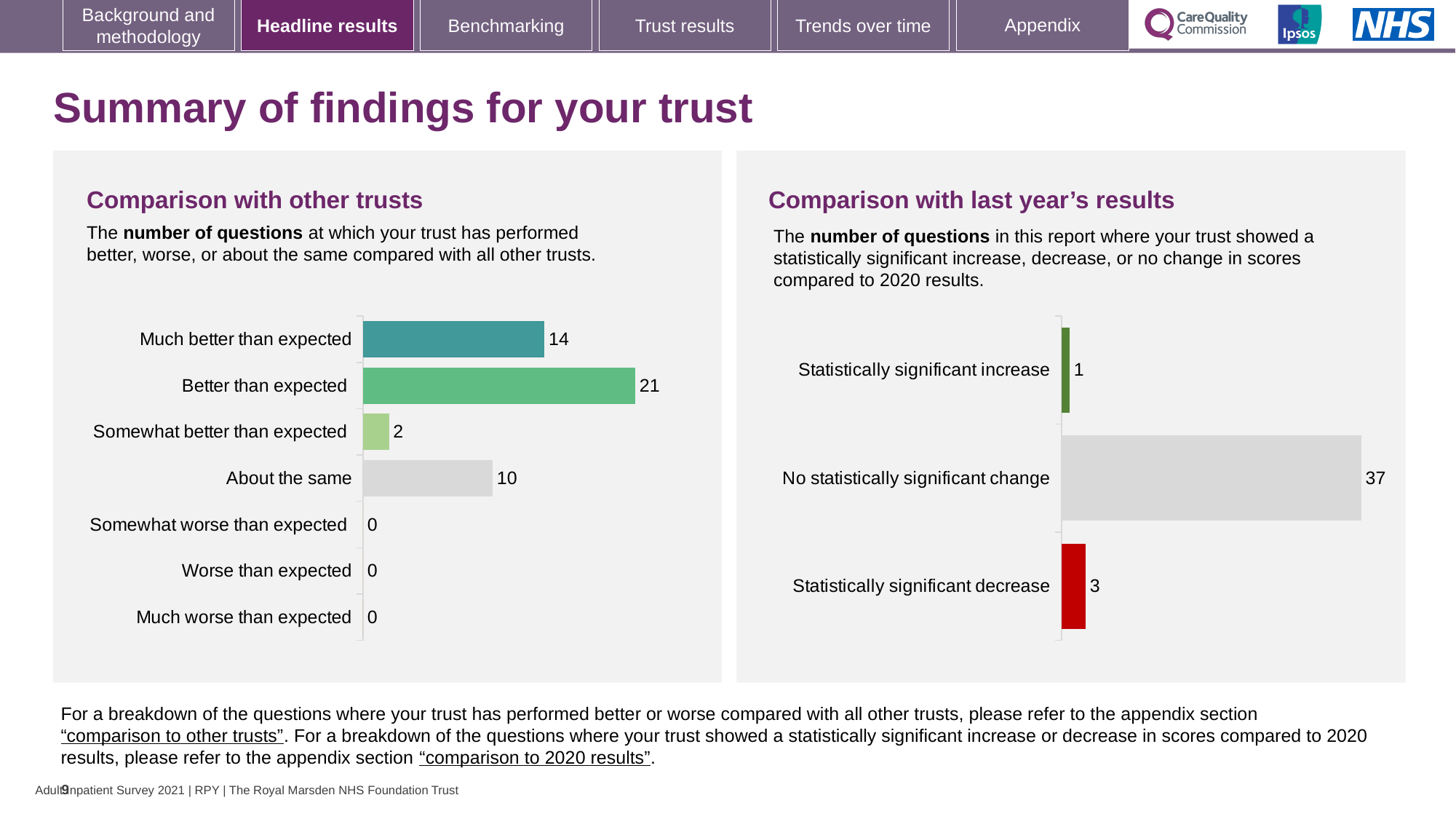
In the 'Comparison with last year's results' chart, which category has the lowest value? Statistically significant increase In the 'Comparison with other trusts' chart, what is the value for 'Worse than expected'? 0 In the 'Comparison with other trusts' chart, which is larger: 'Much better than expected' or 'Somewhat better than expected'? Much better than expected What type of chart is the 'Comparison with last year's results' chart? Bar chart In the 'Comparison with last year's results' chart, how many questions showed no statistically significant change? 37 In the 'Comparison with other trusts' chart, what is the difference between 'Better than expected' and 'About the same'? 11 In the 'Comparison with last year's results' chart, what is the difference between 'Statistically significant decrease' and 'Statistically significant increase'? 2 In the 'Comparison with other trusts' chart, what is the value for 'Much better than expected'? 14 In the 'Comparison with last year's results' chart, what colour is the 'Statistically significant decrease' bar? Red In the 'Comparison with other trusts' chart, which category has the highest value? Better than expected In the 'Comparison with other trusts' chart, how many questions were 'Better than expected'? 21 In the 'Comparison with other trusts' chart, how many categories are shown? 7